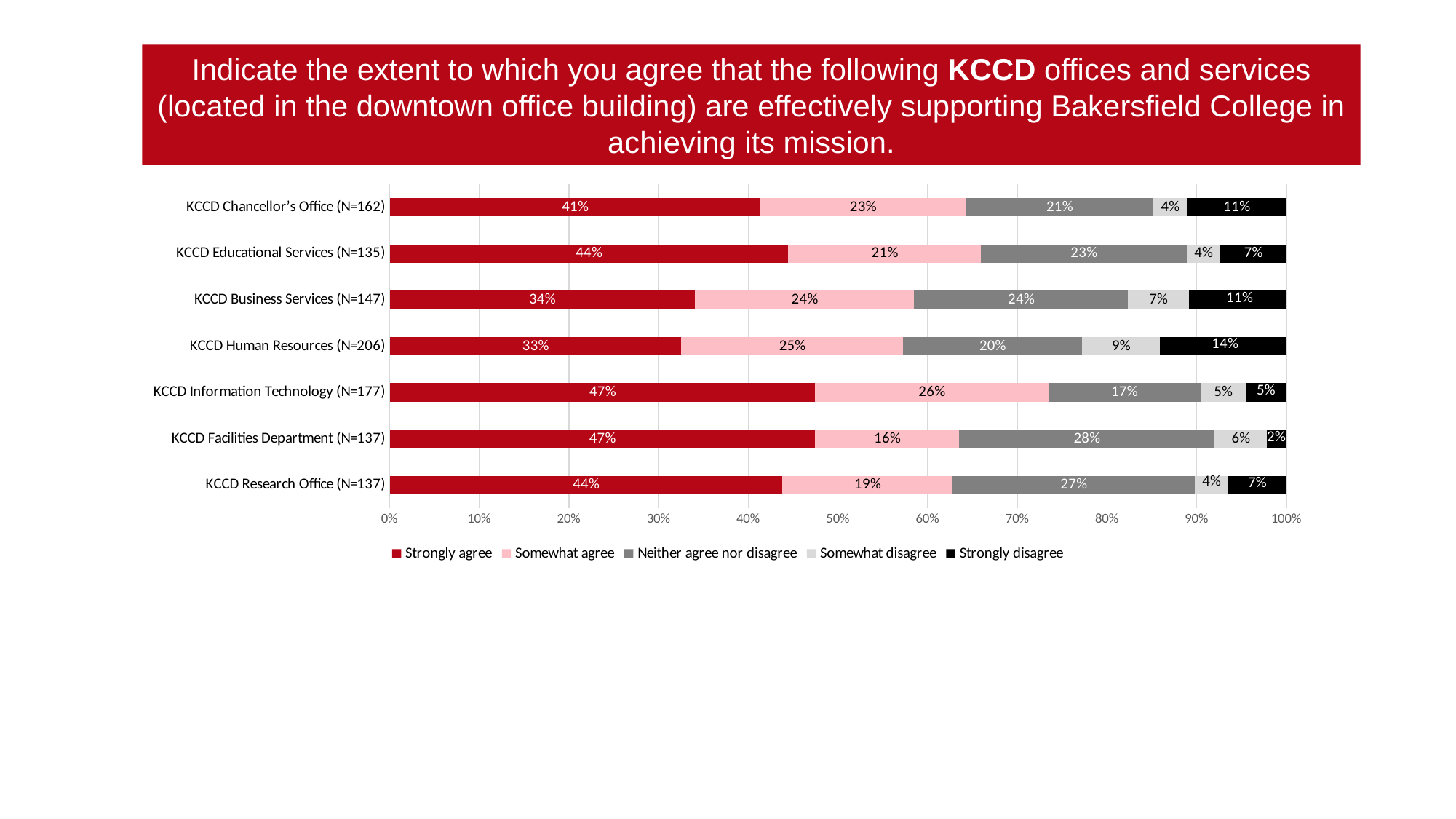
How many response categories does the legend list? 5 What percentage of respondents strongly agree for KCCD Chancellor's Office (N=162)? 41% What is the difference in 'Strongly agree' percentage between KCCD Chancellor's Office (N=162) and KCCD Business Services (N=147)? 7 percentage points What is the 'Neither agree nor disagree' value for KCCD Facilities Department (N=137)? 28% What is the 'Strongly disagree' value for KCCD Human Resources (N=206)? 14% Which office has the lowest 'Strongly disagree' percentage? KCCD Facilities Department (N=137) Is the 'Strongly agree' value for KCCD Information Technology (N=177) greater or less than 40%? greater How many KCCD offices or services are shown in the chart? 7 Which has a higher 'Strongly agree' percentage: KCCD Educational Services (N=135) or KCCD Human Resources (N=206)? KCCD Educational Services (N=135) Which office has the highest 'Strongly disagree' percentage? KCCD Human Resources (N=206) Which office has the lowest 'Somewhat agree' percentage? KCCD Facilities Department (N=137) What type of chart is shown on the slide? Stacked bar chart